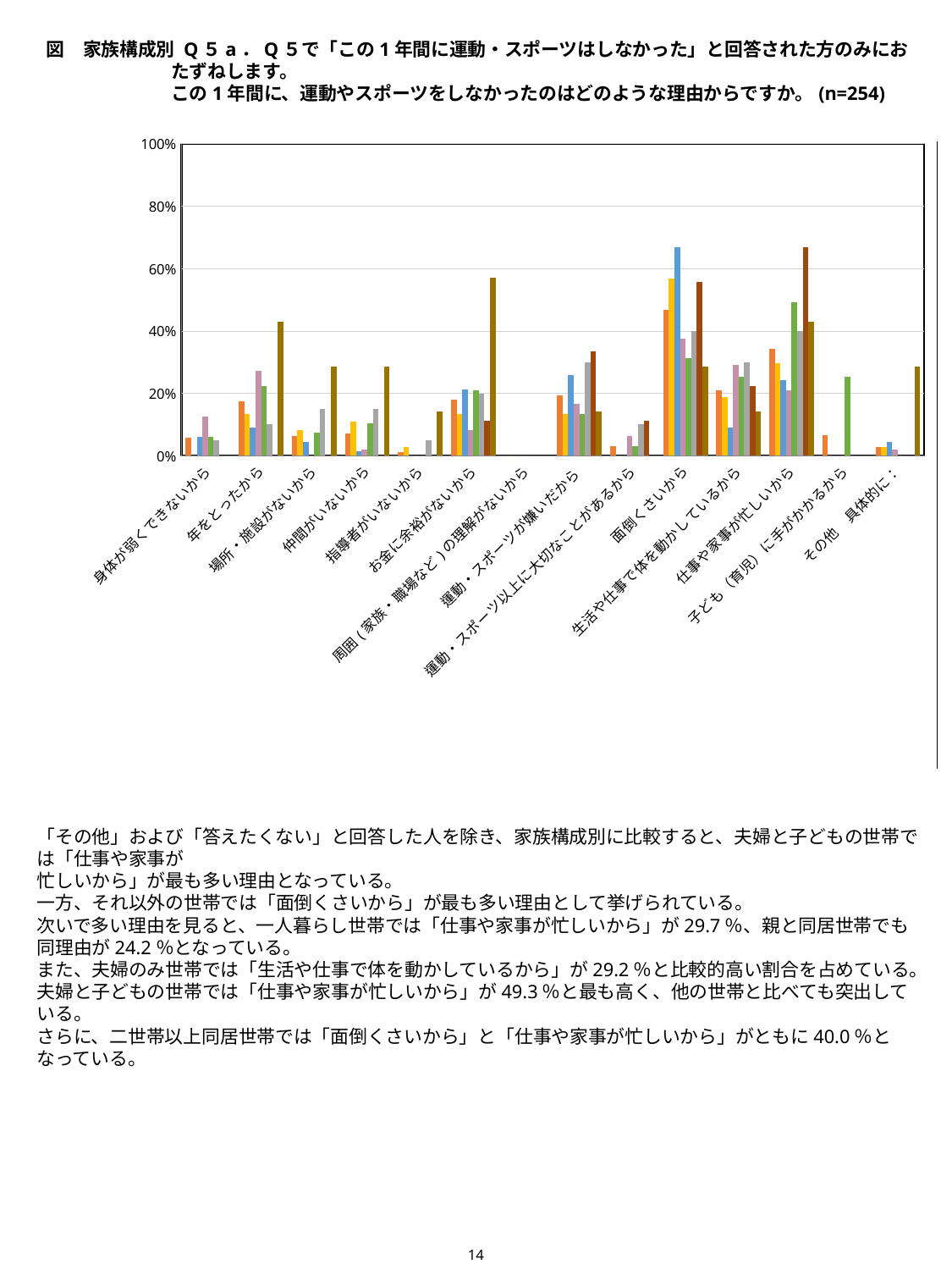
How many reason categories are listed along the x axis of the chart? 14 Is the tallest bar for 運動・スポーツ以上に大切なことがあるから greater or less than 20%? less Which category has a taller tallest bar: 面倒くさいから or 仲間がいないから? 面倒くさいから Is the tallest bar for 年をとったから greater or less than 20%? greater Is the tallest bar for 指導者がいないから greater or less than 40%? less Which category has a taller tallest bar: お金に余裕がないから or 指導者がいないから? お金に余裕がないから What is the maximum value shown on the chart's vertical axis? 100% What kind of chart is shown on the slide? bar chart What sample size (n) is stated in the chart title? n=254